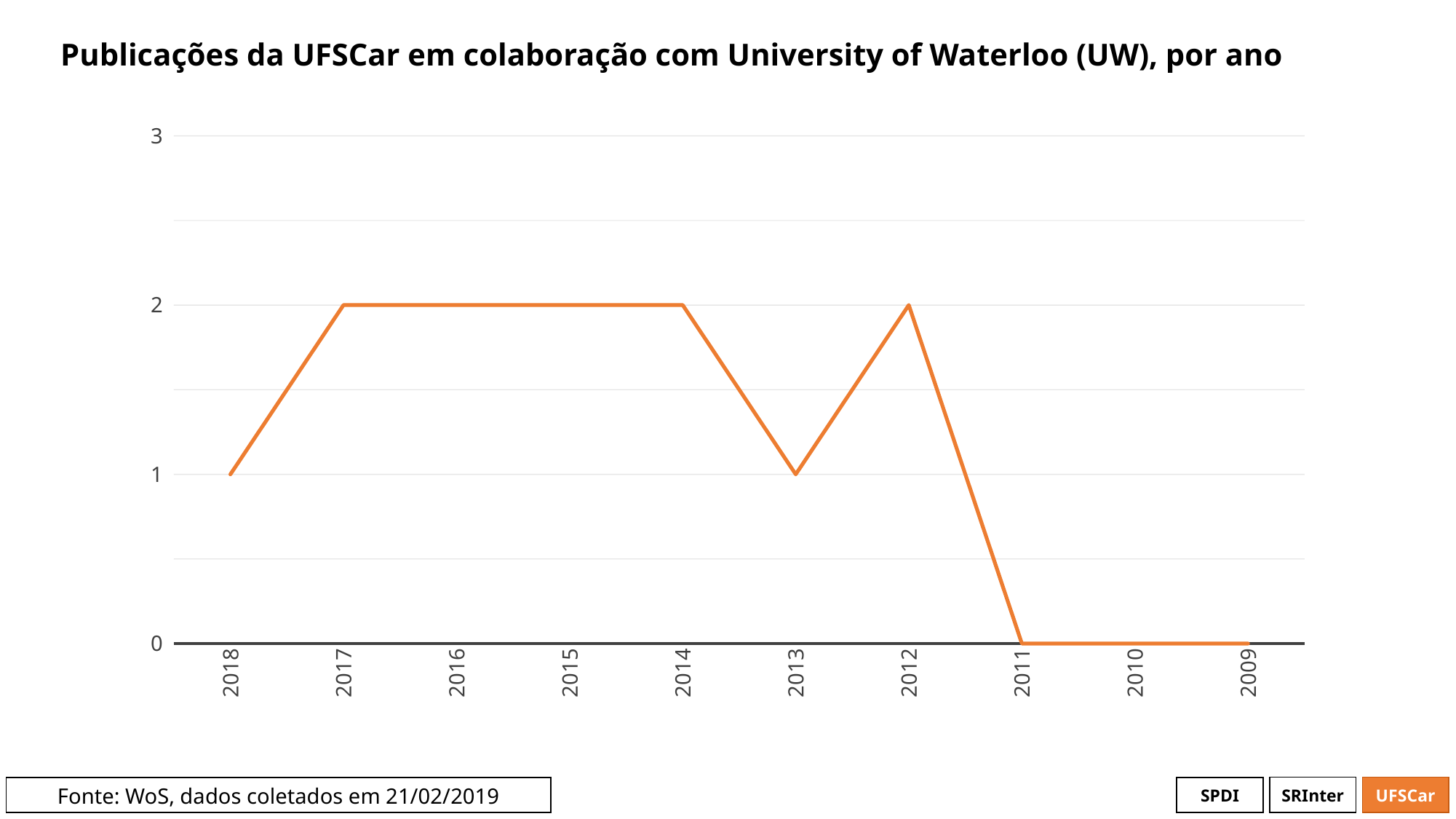
What is the lowest value reached by the line? 0 What is the value for 2018? 1 How many years are plotted on the x axis? 10 What type of chart is shown on the slide? line chart What is the difference between the values for 2017 and 2018? 1 What is the value for 2012? 2 What is the value for 2013? 1 What is the highest value reached by the line? 2 What is the value for 2010? 0 Which year has the larger value, 2013 or 2012? 2012 What is the difference between the values for 2014 and 2011? 2 What is the title of the chart? Publicações da UFSCar em colaboração com University of Waterloo (UW), por ano